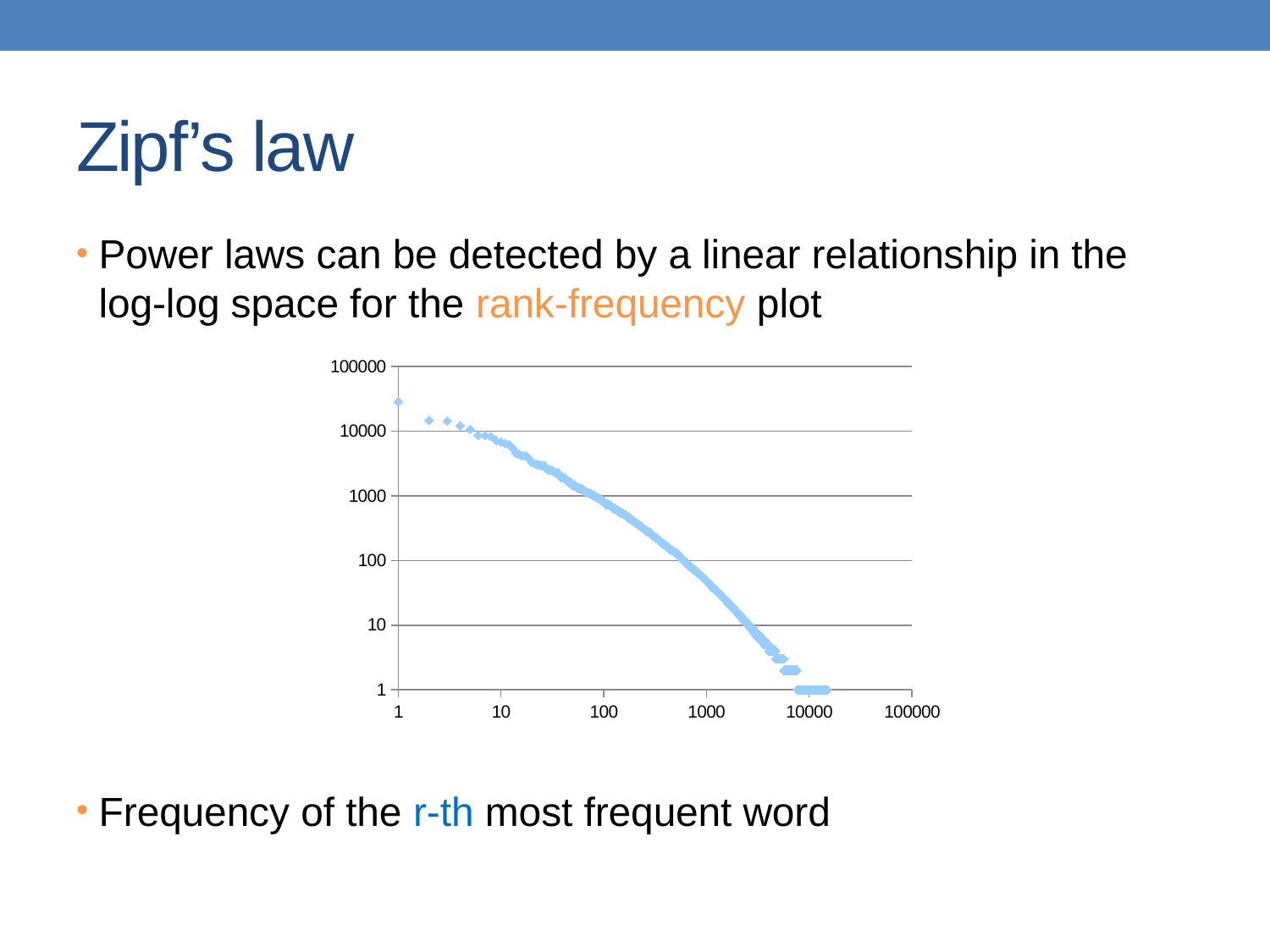
What colour are the plotted points in the chart? light blue Is the value plotted at rank 10 greater or less than 1000? greater Is the value plotted at rank 10 greater or less than 100000? less Is the value plotted at rank 1000 greater or less than 1000? less Do the plotted values rise or fall as rank increases along the x axis? fall What kind of chart is shown on the slide? scatter chart What is the highest tick label shown on the y axis? 100000 Which of the plotted points has the highest value: the one at rank 1 or the one at rank 100? rank 1